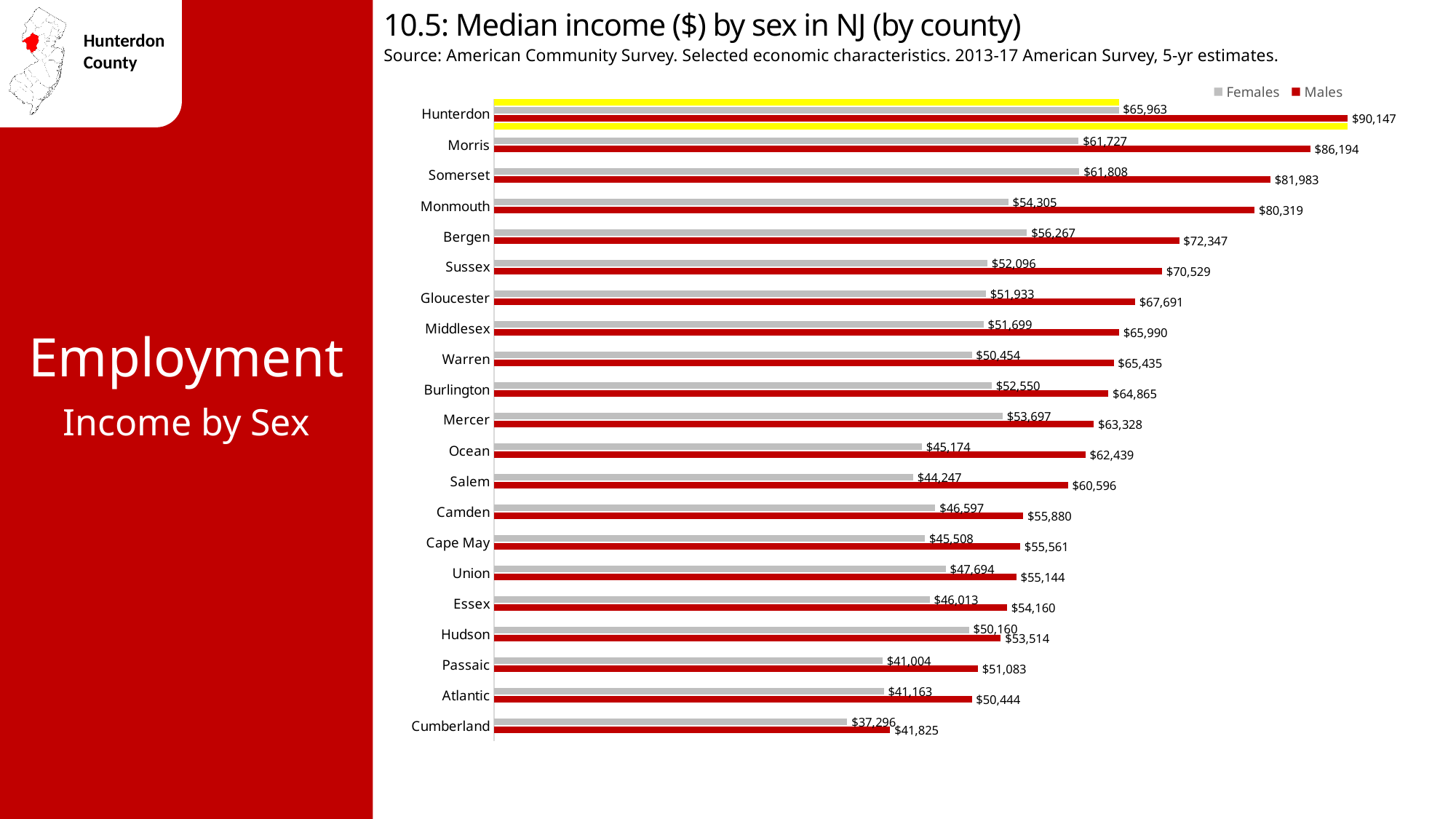
Which county has the highest median income for males? Hunterdon What kind of chart is shown on the slide? Bar chart How many series does the legend list? 2 What is the median income for females in Cumberland County? $37,296 What is the median income for males in Hunterdon County? $90,147 Which county has the lowest median income for females? Cumberland What is the median income for males in Ocean County? $62,439 What is the median income for females in Morris County? $61,727 Which is larger, the female median income in Bergen or in Monmouth? Bergen Which colour represents Males in the chart? Red What is the difference between male and female median income in Hunterdon County? $24,184 How many counties are shown on the chart? 21